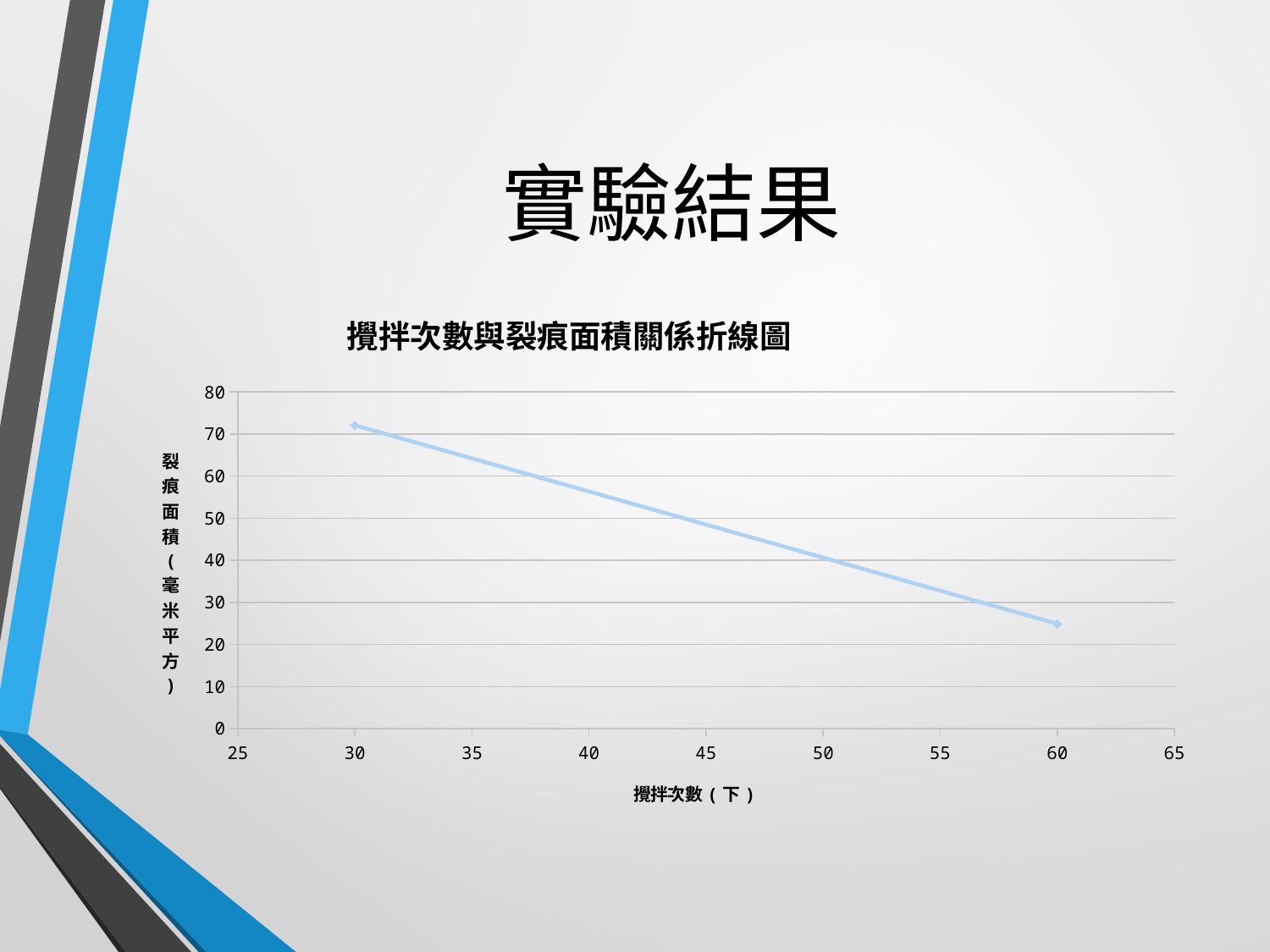
Is the crack area at 60 stirs greater or less than 20? greater Does the crack area rise or fall as the number of stirs increases from 30 to 60? fall At which number of stirs is the crack area lowest? 60 What is the label of the x axis? 攪拌次數（下） Is the crack area at 30 stirs greater or less than 80? less How many data points are plotted on the line? 2 Is the crack area at 30 stirs greater or less than 70? greater What is the title of the chart? 攪拌次數與裂痕面積關係折線圖 Which has the larger crack area, 30 stirs or 60 stirs? 30 stirs What kind of chart is shown on the slide? line chart At which number of stirs is the crack area highest? 30